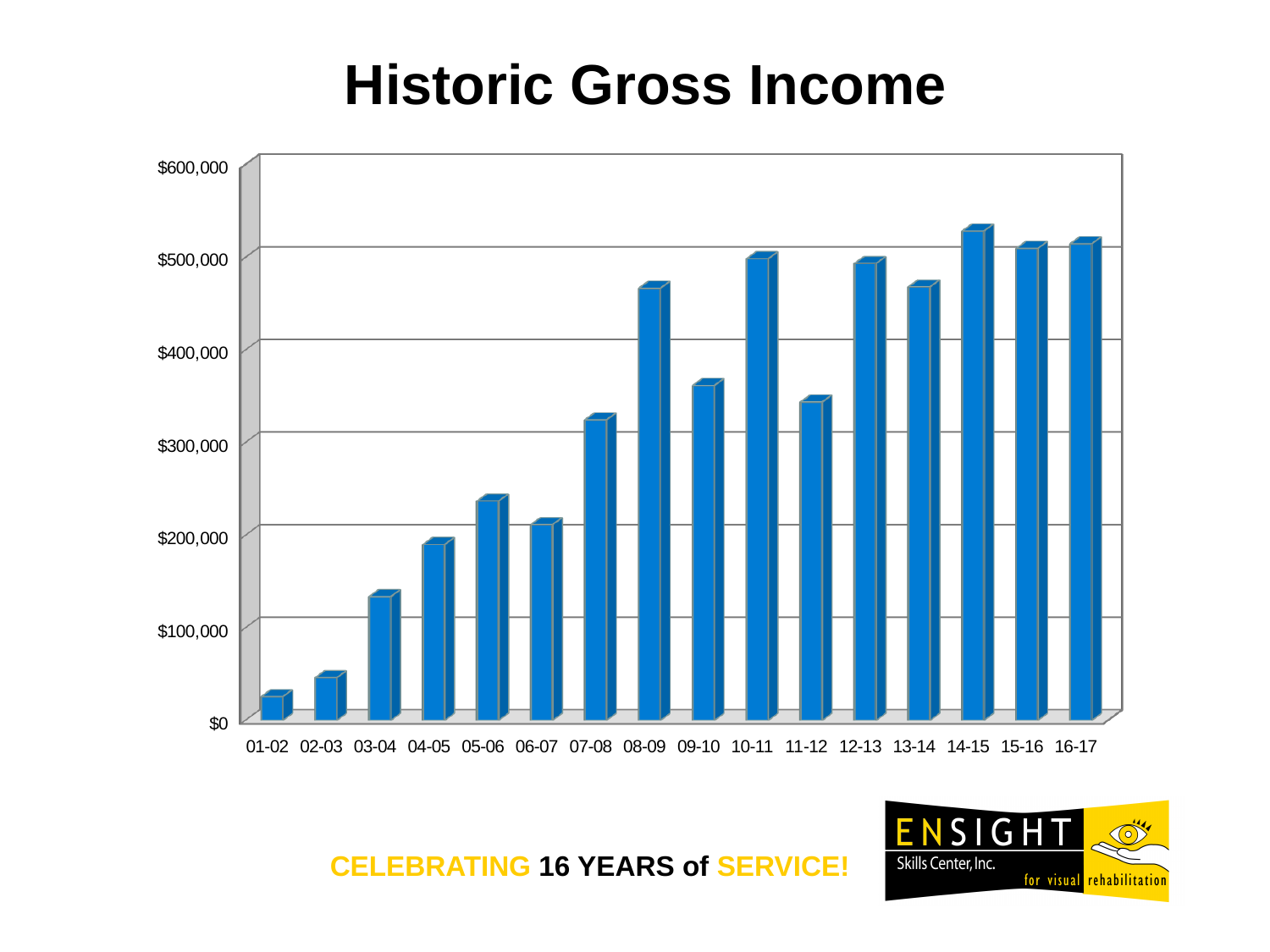
Is the value for 08-09 greater or less than $400,000? greater How many fiscal years (bars) are shown in the chart? 16 Is the value for 11-12 greater or less than $400,000? less Which year has the lowest gross income? 01-02 What is the title of the chart? Historic Gross Income Overall, does gross income rise or fall from 01-02 to 16-17? rise Which is larger, the gross income for 08-09 or for 09-10? 08-09 Is the value for 07-08 greater or less than $300,000? greater Which year has the highest gross income? 14-15 Which is larger, the gross income for 10-11 or for 11-12? 10-11 What kind of chart is shown on the slide? bar chart